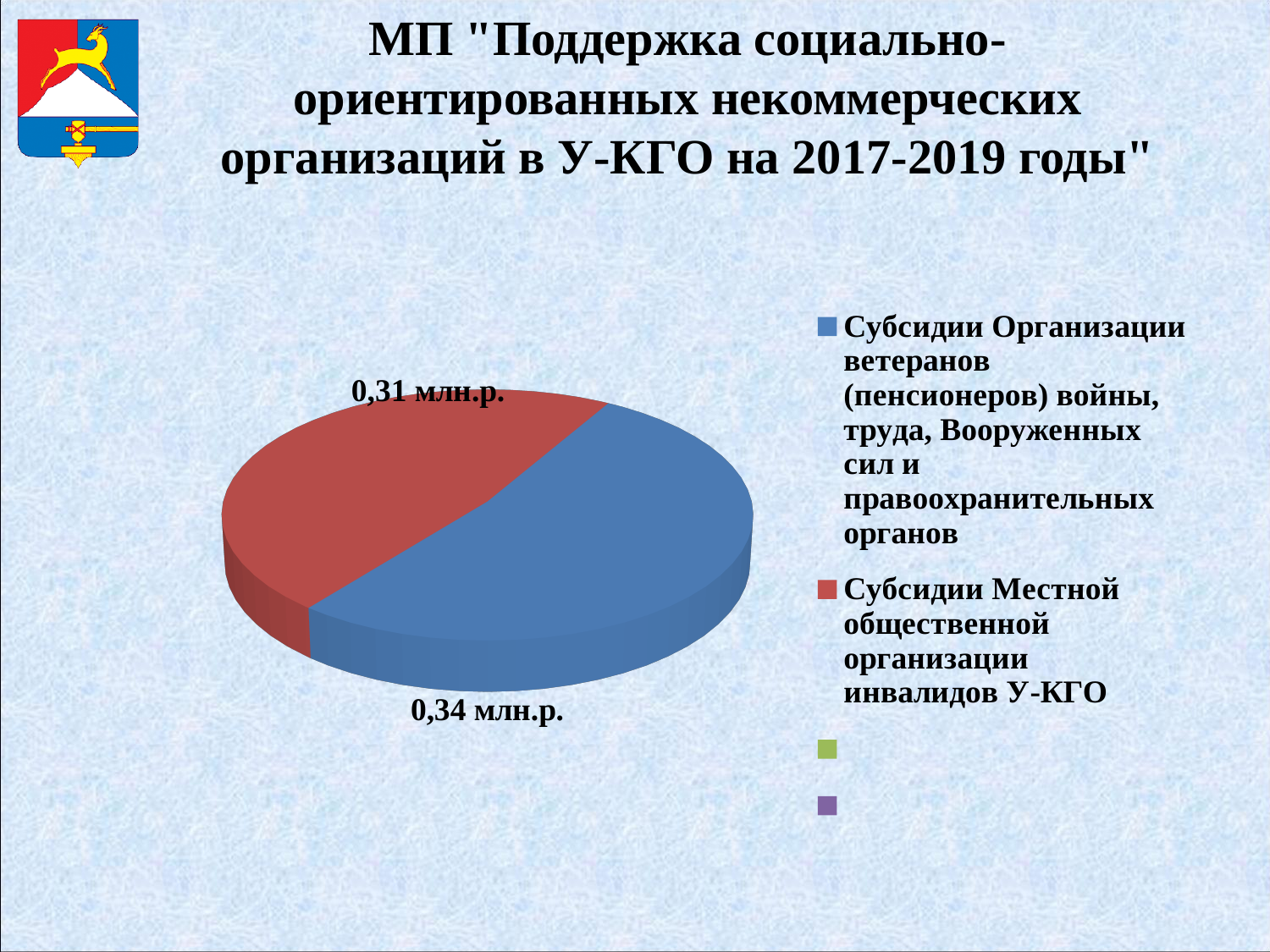
Which slice of the pie is the largest? Субсидии Организации ветеранов (пенсионеров) войны, труда, Вооруженных сил и правоохранительных органов What is the difference between the subsidy for the veterans organization and the subsidy for the disabled persons organization? 0,03 млн.р. How many labeled entries does the legend list? 2 Which is larger: the subsidy for the veterans organization or the subsidy for the disabled persons organization? Субсидии Организации ветеранов (пенсионеров) войны, труда, Вооруженных сил и правоохранительных органов Which slice of the pie is the smallest? Субсидии Местной общественной организации инвалидов У-КГО How many slices does the pie chart have? 2 What kind of chart is shown on the slide? Pie chart What colour is the slice for Субсидии Местной общественной организации инвалидов У-КГО? Red What is the title of the slide containing the pie chart? МП "Поддержка социально-ориентированных некоммерческих организаций в У-КГО на 2017-2019 годы" What is the value of the slice for Субсидии Организации ветеранов (пенсионеров) войны, труда, Вооруженных сил и правоохранительных органов? 0,34 млн.р. What is the total of the two values shown on the pie chart? 0,65 млн.р. What is the value of the slice for Субсидии Местной общественной организации инвалидов У-КГО? 0,31 млн.р.